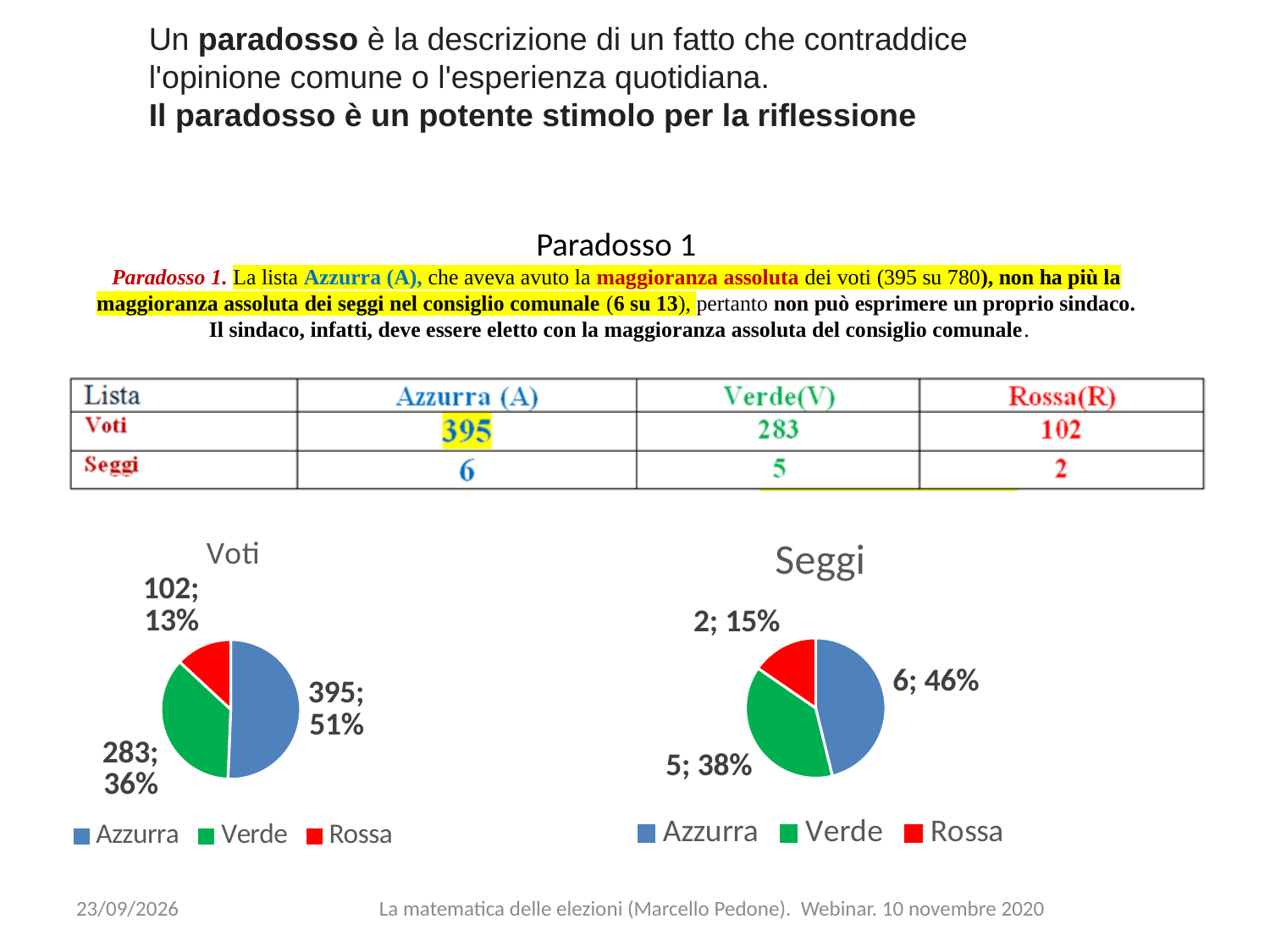
In the Voti chart, which is larger: the value for Verde or the value for Rossa? Verde In the Voti chart, how many votes does Azzurra have? 395 In the Voti chart, what is the difference between the votes for Azzurra and Verde? 112 In the Seggi chart, how many seats does Verde have? 5 In the Voti chart, what share of the pie does Verde hold? 36% In the Seggi chart, what is the difference between the seats for Azzurra and Rossa? 4 What kind of chart is the Voti chart? Pie chart How many slices does the Seggi chart have? 3 In the Voti chart, which list has the fewest votes? Rossa In the Seggi chart, which list has the most seats? Azzurra Which colour represents Rossa in the legend of the Seggi chart? Red In the Seggi chart, what share of the pie does Rossa hold? 15%